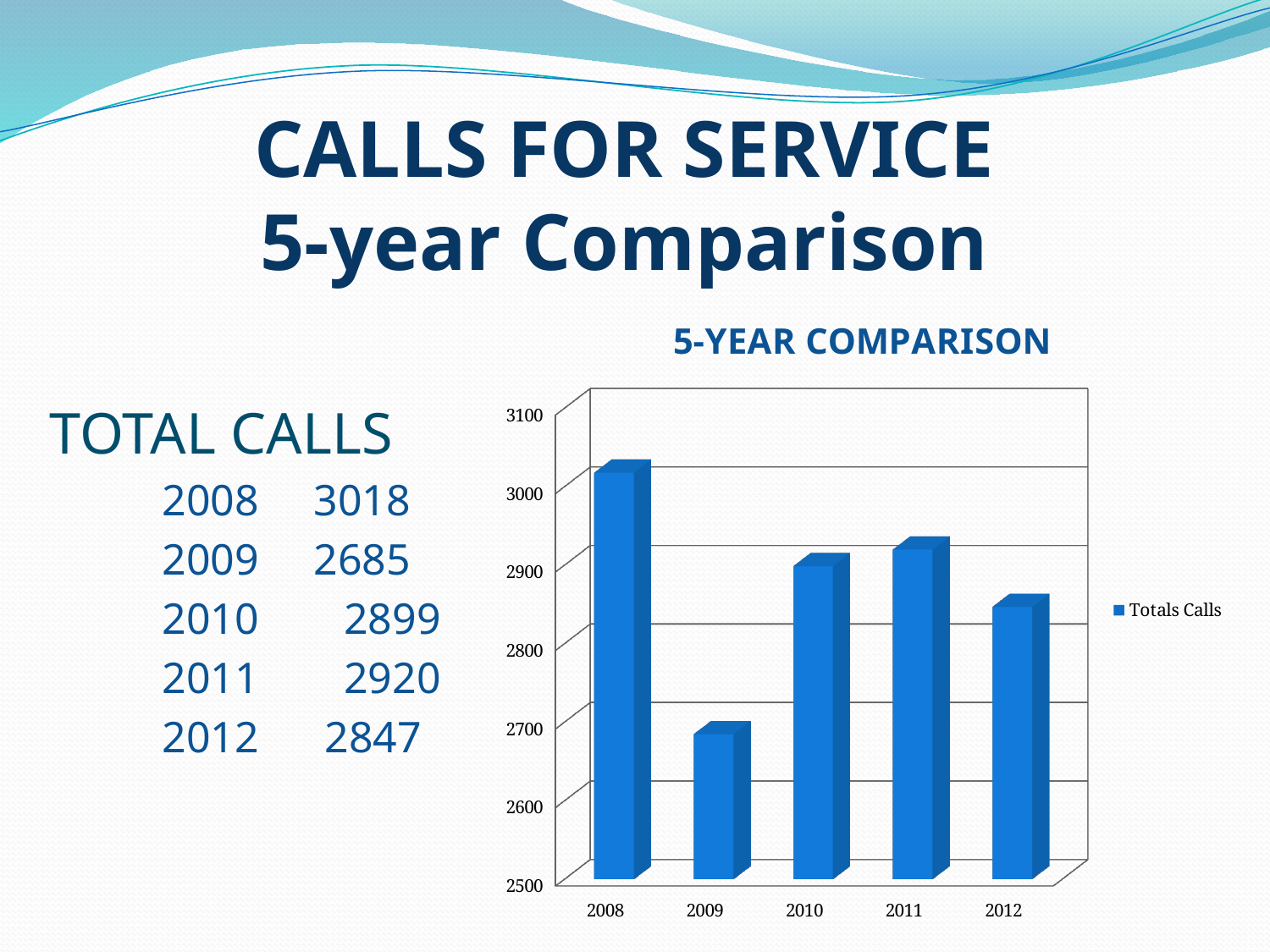
What is the total calls value for 2008? 3018 What is the title of the chart? 5-YEAR COMPARISON Which year has the lowest total calls in the chart? 2009 What is the total calls value for 2012? 2847 What is the name of the series in the chart legend? Totals Calls What kind of chart is shown on the slide? bar chart Is the value for 2009 greater or less than 2700? less Which year has more total calls, 2010 or 2011? 2011 How many years are plotted on the x axis of the chart? 5 Which year has the highest total calls in the chart? 2008 How many series does the chart legend list? 1 What is the difference in total calls between 2008 and 2009? 333